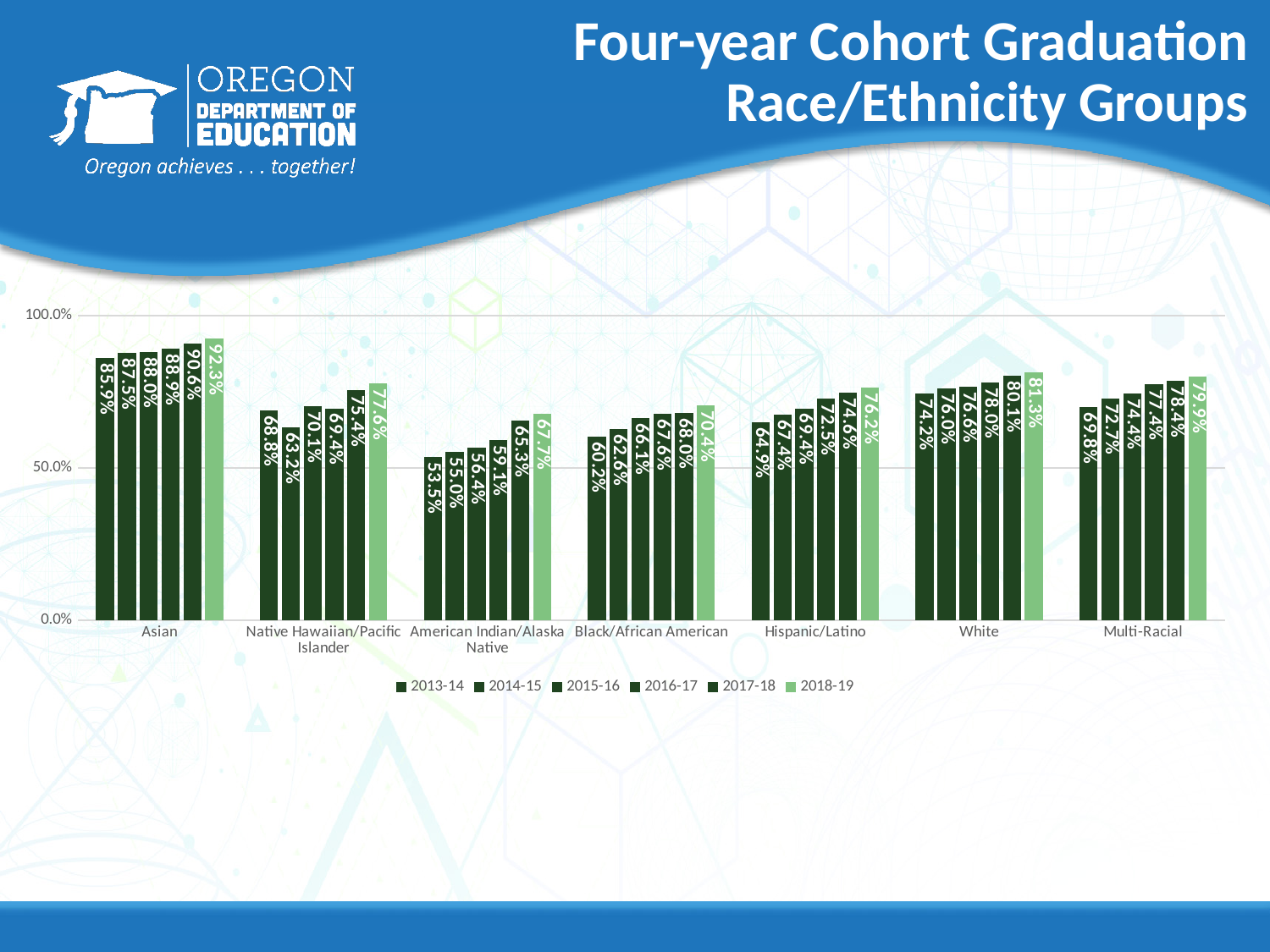
How many race/ethnicity groups are shown on the chart? 7 What was the graduation rate for American Indian/Alaska Native students in 2013-14? 53.5% Which group had a higher graduation rate in 2018-19: White or Multi-Racial? White How much did the graduation rate for Black/African American students increase from 2013-14 (60.2%) to 2018-19 (70.4%)? 10.2 percentage points Which race/ethnicity group had the lowest graduation rate in 2013-14? American Indian/Alaska Native How many school years does the legend list? 6 Did the graduation rate for White students rise or fall from 2013-14 to 2018-19? Rise Which race/ethnicity group had the highest graduation rate in 2018-19? Asian What type of chart is used to show the graduation rates? Bar chart Is the 2014-15 graduation rate for Native Hawaiian/Pacific Islander students greater or less than 50.0%? greater What was the four-year cohort graduation rate for Asian students in 2018-19? 92.3% What was the graduation rate for Hispanic/Latino students in 2016-17? 72.5%